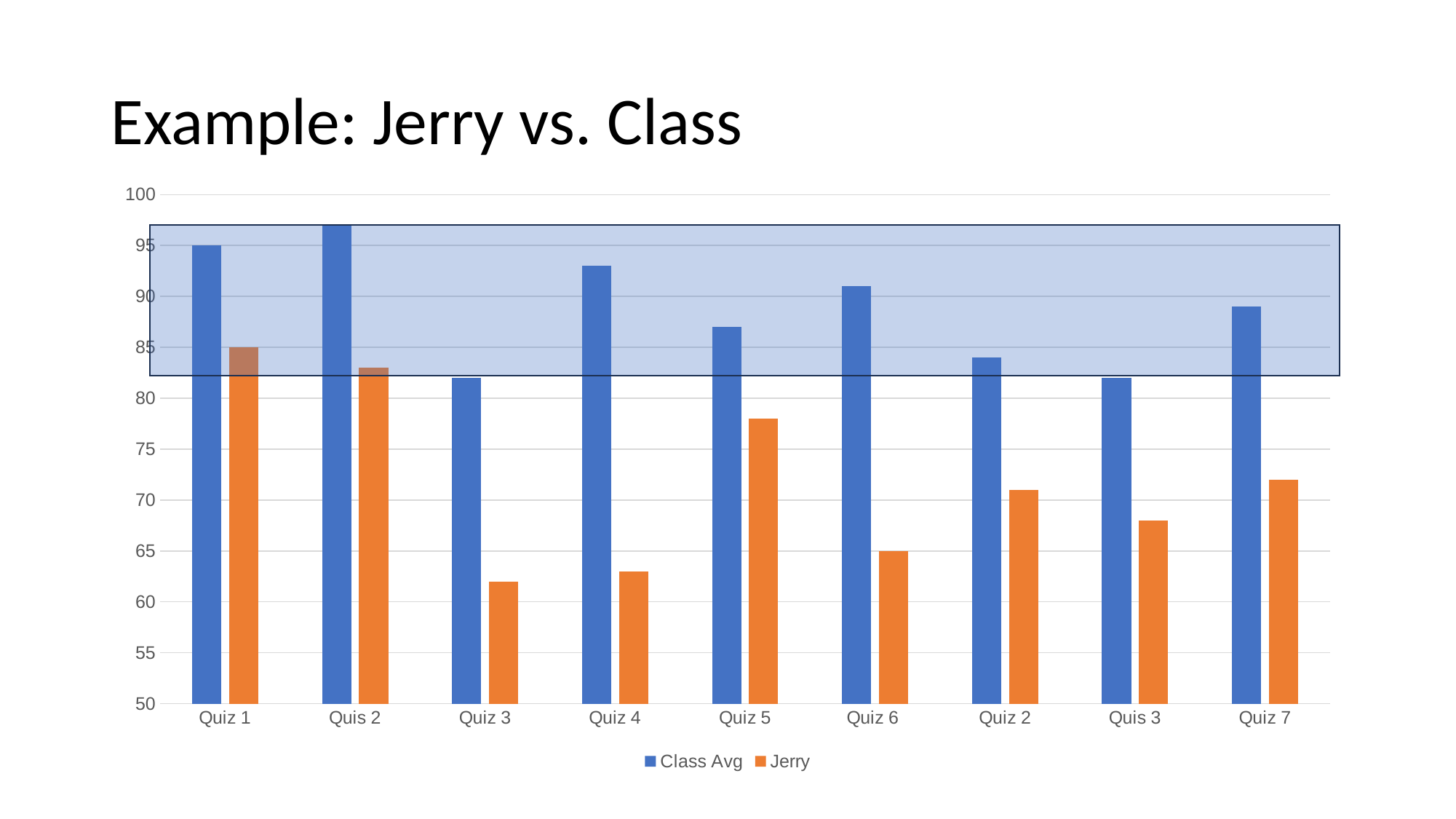
What is the Class Avg value for Quiz 1? 95 How many quiz categories are shown on the x axis? 9 What kind of chart is shown on the slide? bar chart What is Jerry's value for Quiz 6? 65 Is the Class Avg value for Quis 2 greater or less than 95? greater For which quiz is the Class Avg highest? Quis 2 What is the difference between the Class Avg and Jerry's value for Quiz 1? 10 How many series does the legend list? 2 What is Jerry's value for Quiz 1? 85 Which is larger for Quiz 3, the Class Avg or Jerry's value? Class Avg Is Jerry's value for Quiz 5 greater or less than 75? greater Is Jerry's value for Quiz 3 greater or less than 65? less